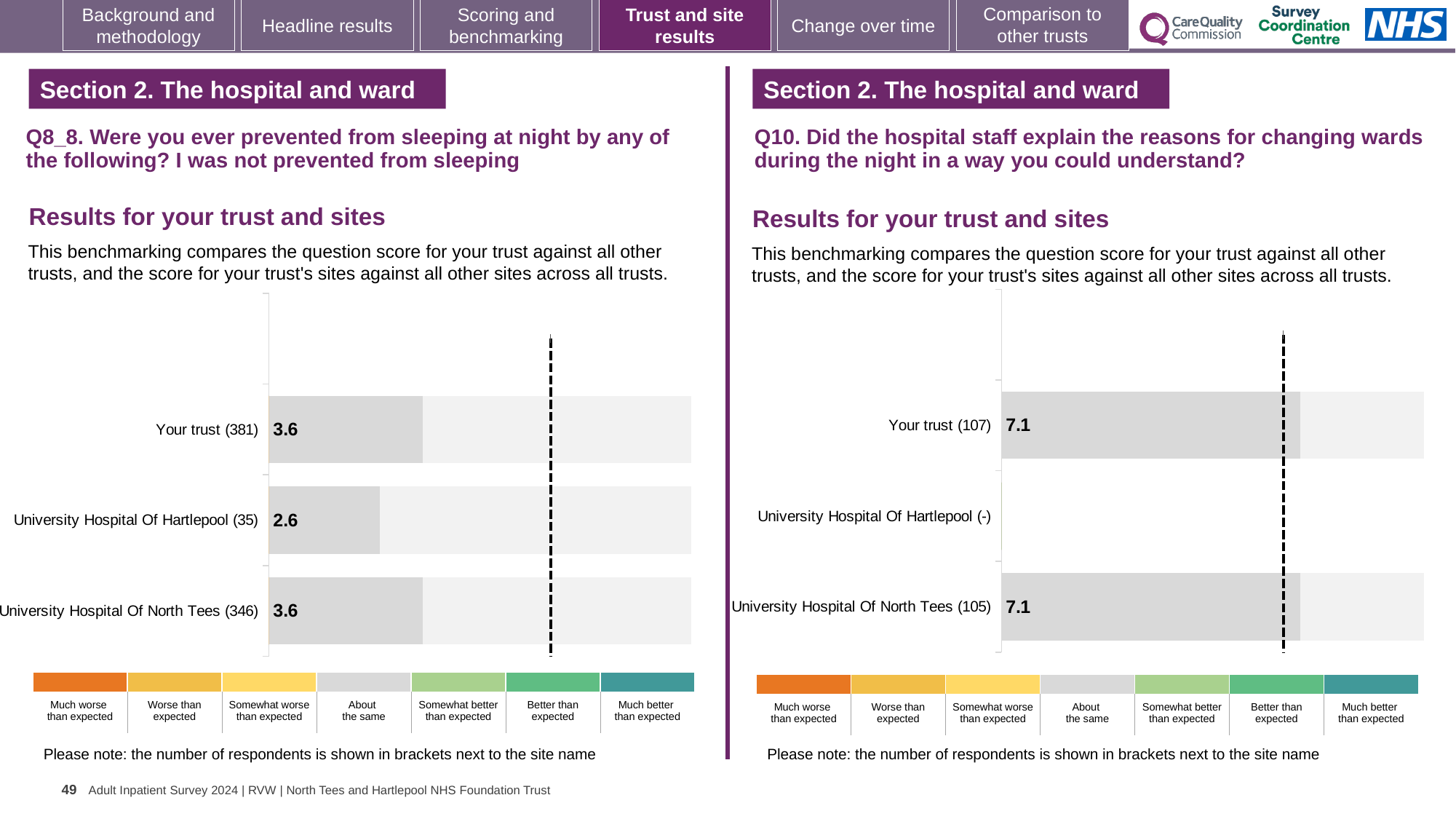
What kind of chart is the Q8_8 chart on the left? Bar chart In the Q8_8 chart on the left, what is the score for Your trust? 3.6 In the Q8_8 chart on the left, what is the score for University Hospital Of Hartlepool? 2.6 In the Q8_8 chart on the left, what is the difference between the scores for University Hospital Of North Tees and University Hospital Of Hartlepool? 1.0 In the Q8_8 chart on the left, how many respondents are shown in brackets for University Hospital Of North Tees? 346 In the Q10 chart on the right, how many respondents are shown in brackets for Your trust? 107 In the Q10 chart on the right, what is the score for University Hospital Of North Tees? 7.1 In the Q10 chart on the right, what is the score for Your trust? 7.1 In the Q8_8 chart on the left, what is the score for University Hospital Of North Tees? 3.6 In the Q8_8 chart on the left, which has the larger score, Your trust or University Hospital Of Hartlepool? Your trust In the Q8_8 chart on the left, which site has the lowest score? University Hospital Of Hartlepool How many categories (rows) are shown in the Q10 chart on the right? 3